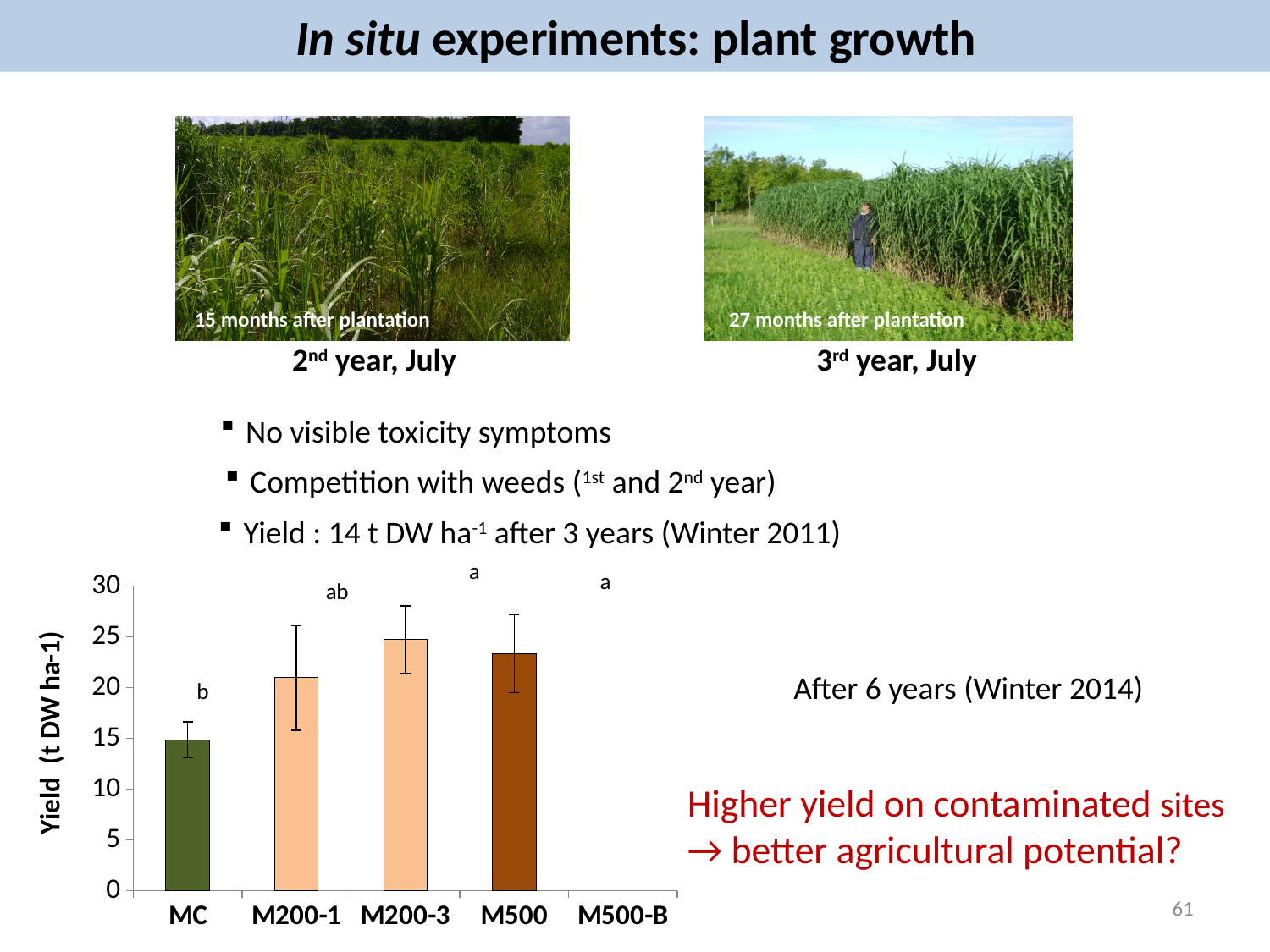
What kind of chart is shown on the slide? bar chart Is the yield for M500 greater or less than 25? less Is the yield for M500 greater or less than 20? greater Is the yield for MC greater or less than 20? less Which category has the lowest yield in the chart? MC What is the label of the y axis of the chart? Yield (t DW ha-1) How many categories are labelled on the x axis of the chart? 5 Which has a higher yield, MC or M200-1? M200-1 What letter is printed above the MC bar in the chart? b Which has a higher yield, MC or M500? M500